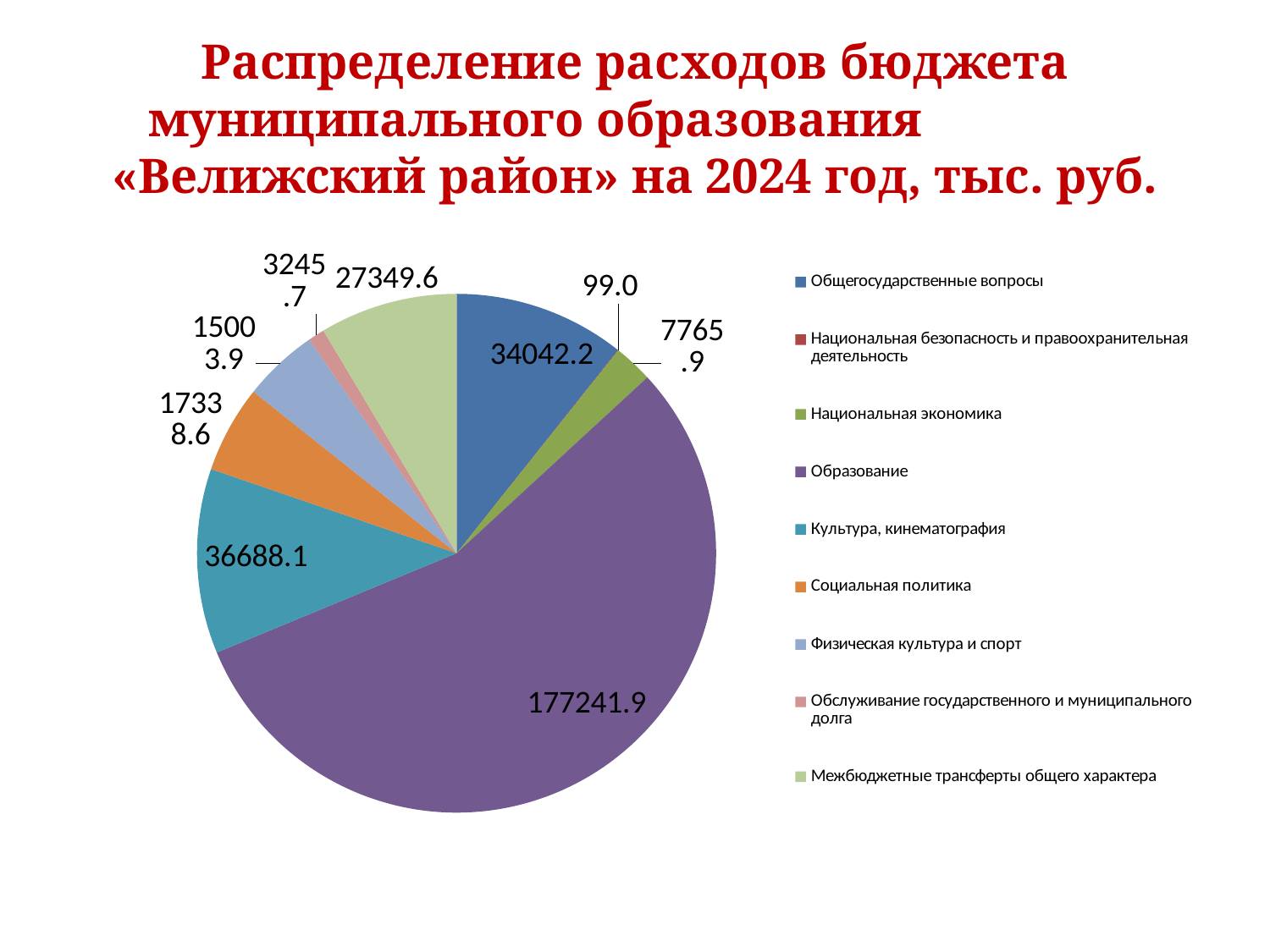
What is the value for Культура, кинематография? 36688.1 What is the value for Образование? 177241.9 How many categories does the pie chart show? 9 Which is larger, Социальная политика or Физическая культура и спорт? Социальная политика What is the value for Межбюджетные трансферты общего характера? 27349.6 Which category has the largest share of the pie? Образование What kind of chart is shown on the slide? pie chart What unit is stated in the chart title for the values? тыс. руб. What is the difference between the values for Культура, кинематография and Общегосударственные вопросы? 2645.9 What is the value for Общегосударственные вопросы? 34042.2 What is the value for Национальная безопасность и правоохранительная деятельность? 99.0 Which category has the smallest value? Национальная безопасность и правоохранительная деятельность